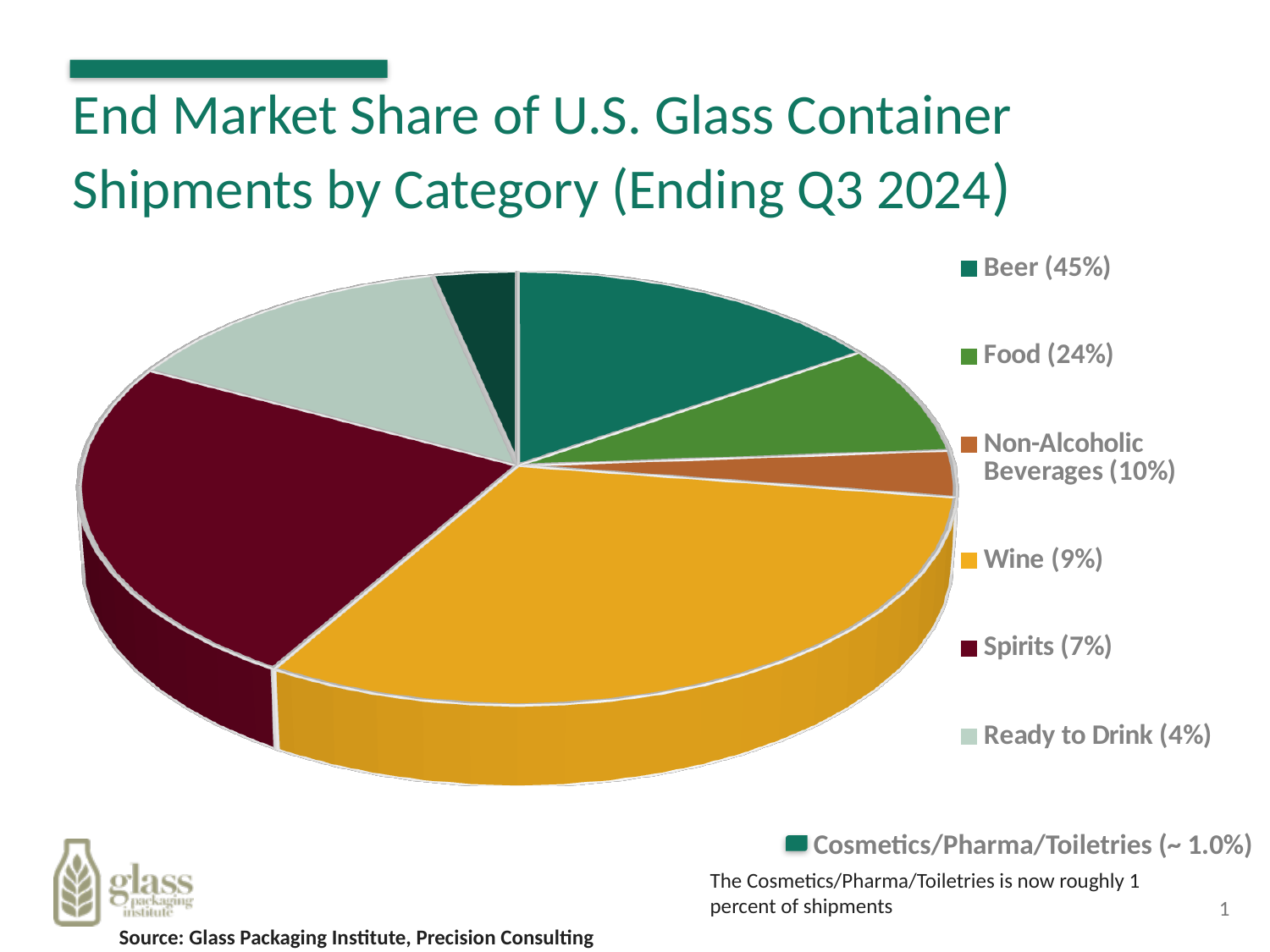
What share of U.S. glass container shipments does Beer account for? 45% Which has the larger share, Wine or Spirits? Wine What share is shown for Food? 24% What kind of chart is shown on the slide? Pie chart What share is shown for Ready to Drink? 4% How many categories are listed in the legend? 7 Which category has the smallest share according to the legend? Cosmetics/Pharma/Toiletries How many percentage points larger is Beer's share than Food's share? 21% What share is shown for Spirits? 7% What share is shown for Non-Alcoholic Beverages? 10% Which category has the largest share according to the legend? Beer What is the title of the chart on the slide? End Market Share of U.S. Glass Container Shipments by Category (Ending Q3 2024)